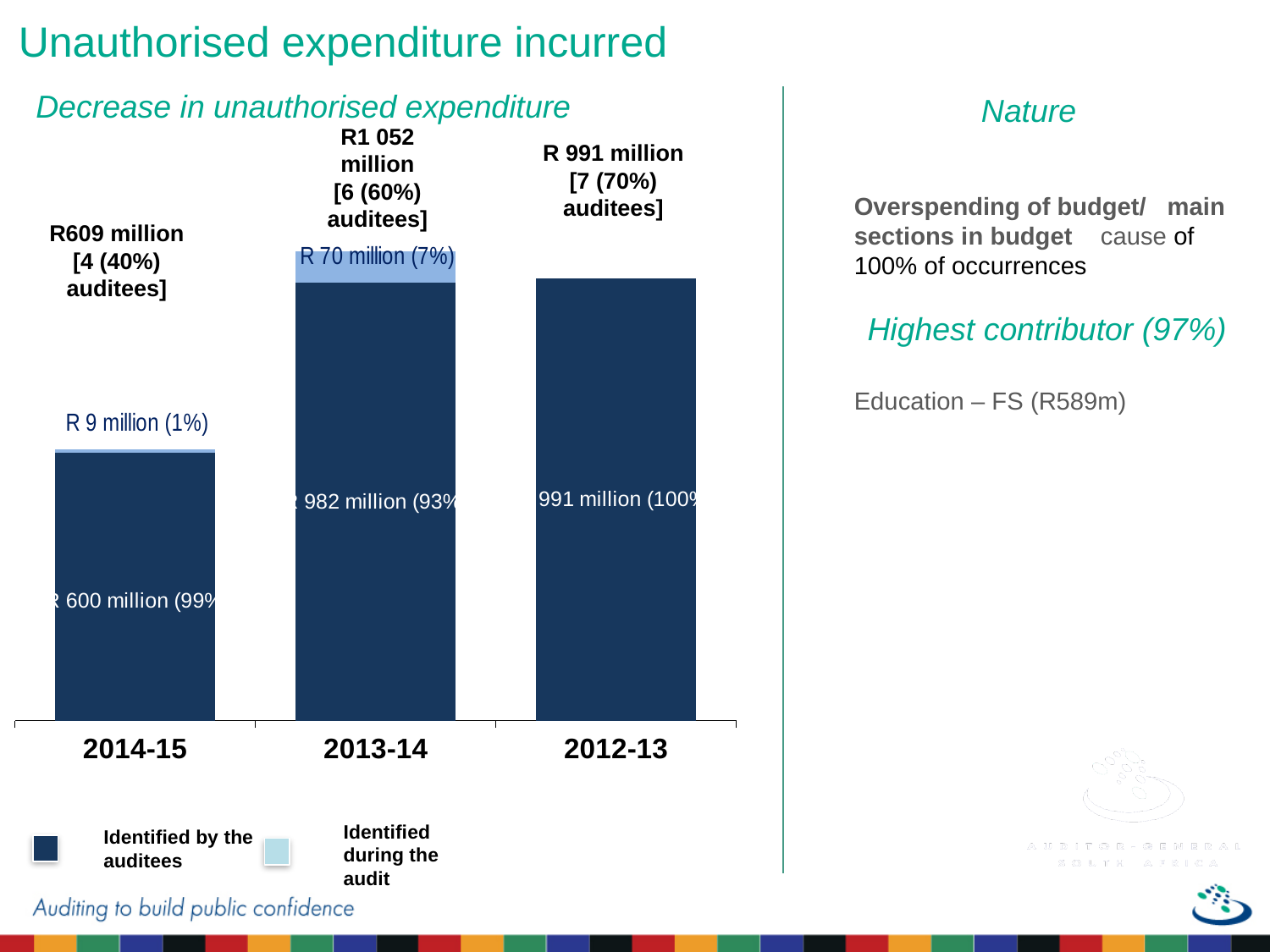
What amount was identified during the audit in 2013-14? R 70 million (7%) Which year has the highest total unauthorised expenditure? 2013-14 How many series does the chart legend list? 2 Which series in the legend is shown in dark blue? Identified by the auditees How many auditees incurred unauthorised expenditure in 2012-13, according to the chart label? 7 (70%) Which year has the lowest total unauthorised expenditure? 2014-15 What is the total unauthorised expenditure shown for 2014-15? R609 million What type of chart is shown on the slide? bar chart What amount was identified during the audit in 2014-15? R 9 million (1%) What is the total unauthorised expenditure shown for 2013-14? R1 052 million How many years (categories) are shown on the x axis of the chart? 3 What is the total unauthorised expenditure shown for 2012-13? R 991 million